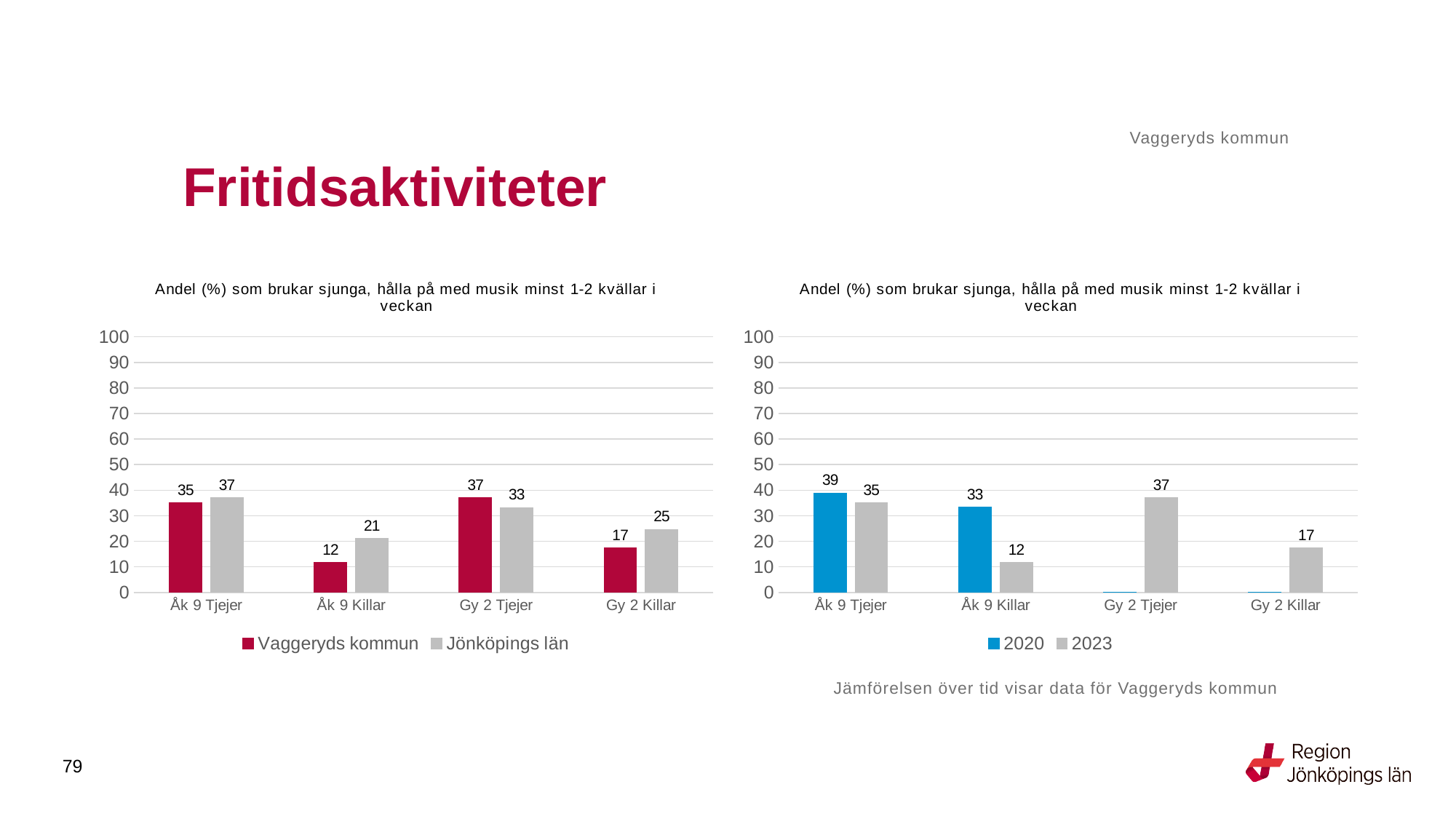
In the right chart, what is the difference between 2020 and 2023 for Åk 9 Killar? 21 In the left chart, what is the value for Jönköpings län for Gy 2 Killar? 25 In the right chart, which category has the highest value for 2020? Åk 9 Tjejer In the left chart, how many series does the legend list? 2 How many categories are shown on the x axis of the right chart? 4 In the left chart, which is larger for Gy 2 Tjejer: Vaggeryds kommun or Jönköpings län? Vaggeryds kommun What kind of chart is the left chart? Bar chart In the left chart, what is the difference between Jönköpings län and Vaggeryds kommun for Åk 9 Killar? 9 In the right chart, what is the value for 2020 for Åk 9 Killar? 33 In the left chart, what is the value for Vaggeryds kommun for Åk 9 Tjejer? 35 In the right chart, what is the value for 2023 for Gy 2 Tjejer? 37 In the left chart, which category has the lowest value for Vaggeryds kommun? Åk 9 Killar